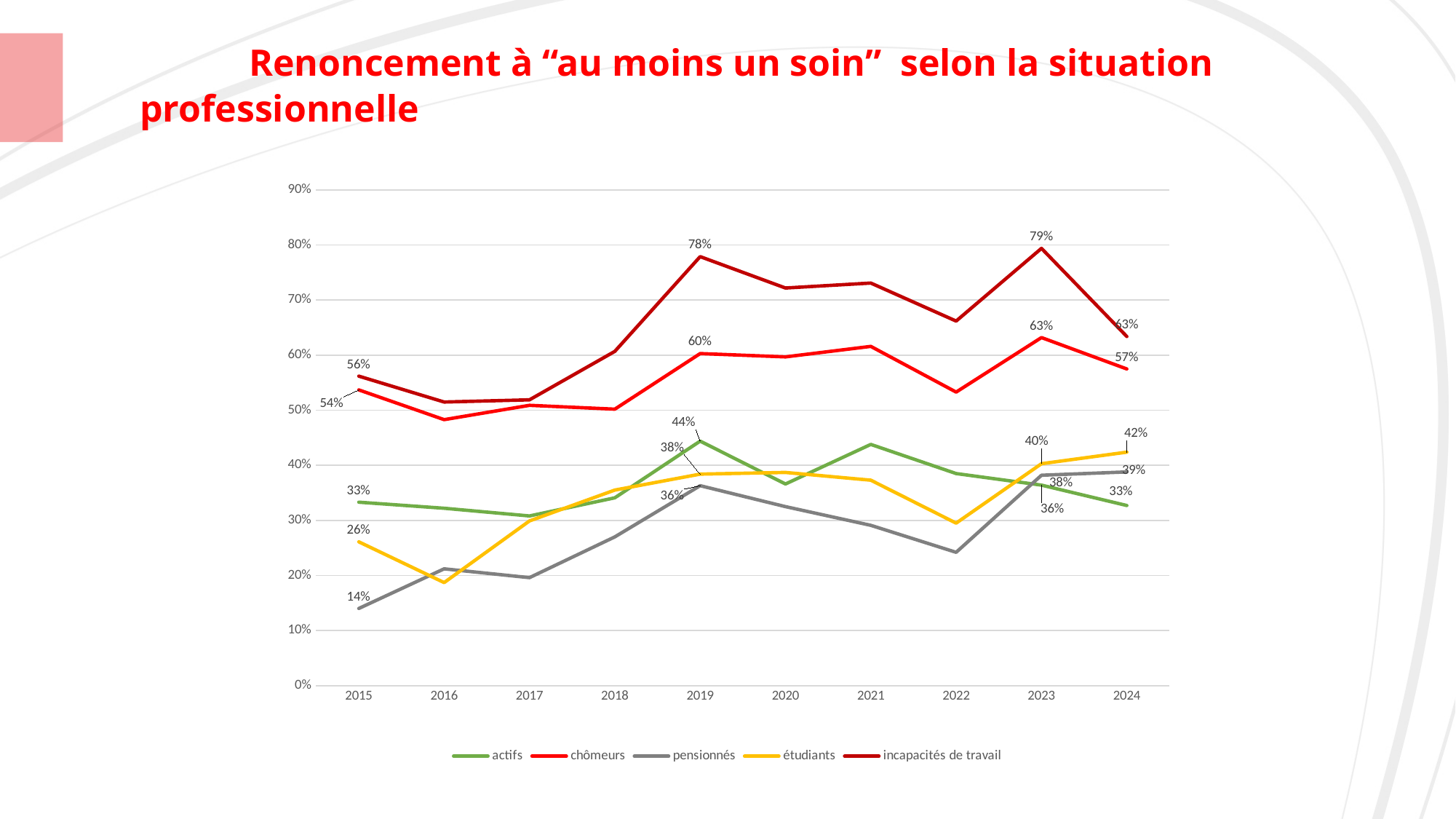
What kind of chart is shown on the slide? Line chart In 2024, which is higher: étudiants or actifs? étudiants How many series does the legend list? 5 What is the value for pensionnés in 2015? 14% By how many percentage points did the value for incapacités de travail fall from 2023 to 2024? 16 percentage points What is the value for étudiants in 2024? 42% What is the value for incapacités de travail in 2023? 79% What is the value for chômeurs in 2019? 60% Which series has the lowest value in 2015? pensionnés How many years are shown on the x axis? 10 Which series has the highest value in 2023? incapacités de travail Is the value for pensionnés in 2022 greater or less than 30%? less